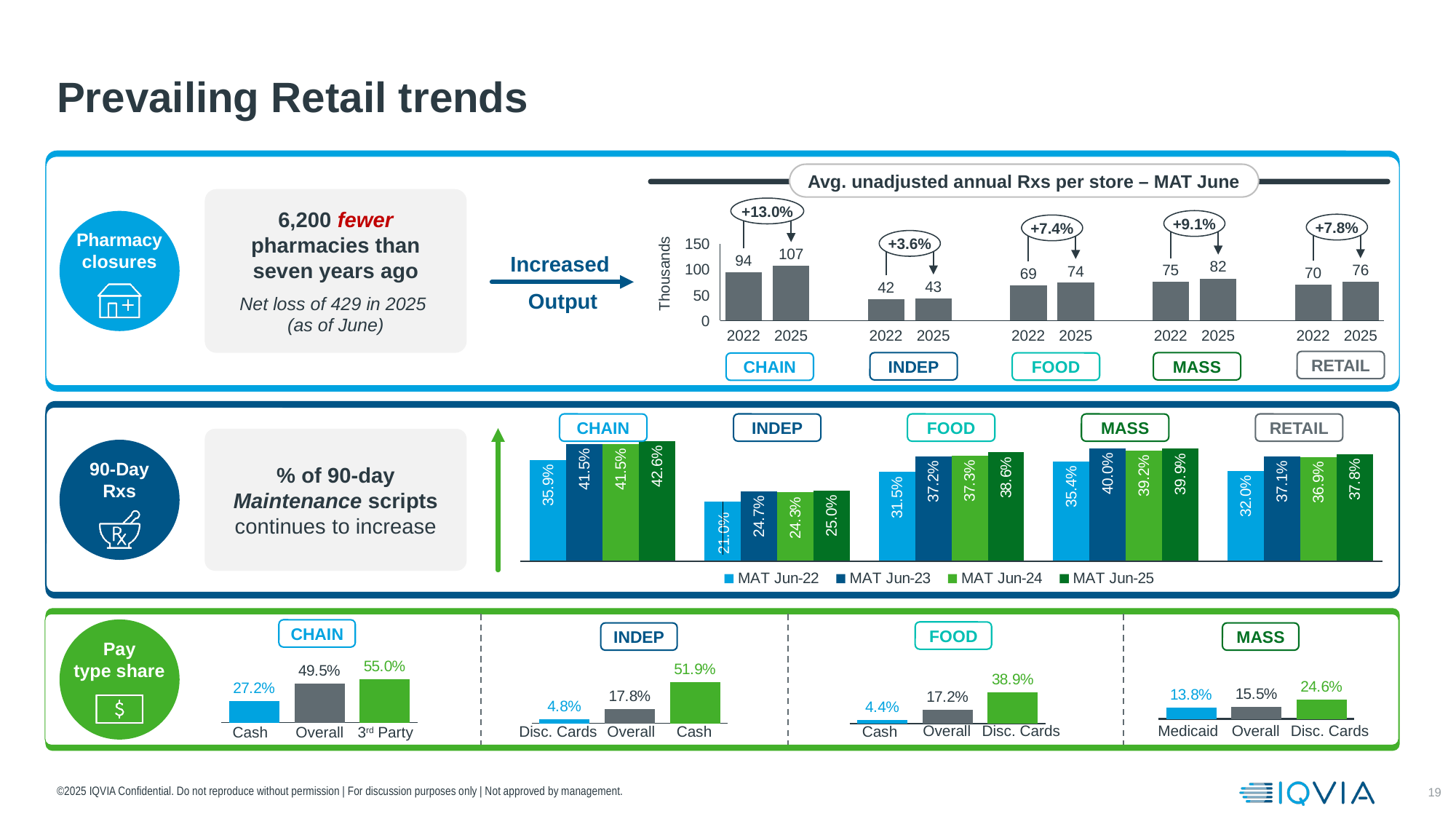
In the 90-Day Rxs chart, how many series does the legend list? 4 In the 'Avg. unadjusted annual Rxs per store – MAT June' chart, what is the value for INDEP in 2022? 42 In the 'Avg. unadjusted annual Rxs per store – MAT June' chart, what is the value for CHAIN in 2025? 107 In the 'Avg. unadjusted annual Rxs per store – MAT June' chart, which channel has the lowest value in 2025? INDEP In the 'Avg. unadjusted annual Rxs per store – MAT June' chart, what is the difference between the MASS values for 2025 and 2022? 7 In the Pay type share CHAIN chart, what is the value for 3rd Party? 55.0% In the 'Avg. unadjusted annual Rxs per store – MAT June' chart, what percentage change is shown for FOOD? +7.4% In the Pay type share MASS chart, which category has the highest value? Disc. Cards In the 90-Day Rxs chart, what is the value for CHAIN in MAT Jun-25? 42.6% In the 90-Day Rxs chart, is the FOOD value for MAT Jun-25 larger or smaller than the MASS value for MAT Jun-25? smaller In the 90-Day Rxs chart, which channel has the lowest value for MAT Jun-22? INDEP In the Pay type share INDEP chart, what is the difference between Cash and Overall? 34.1%